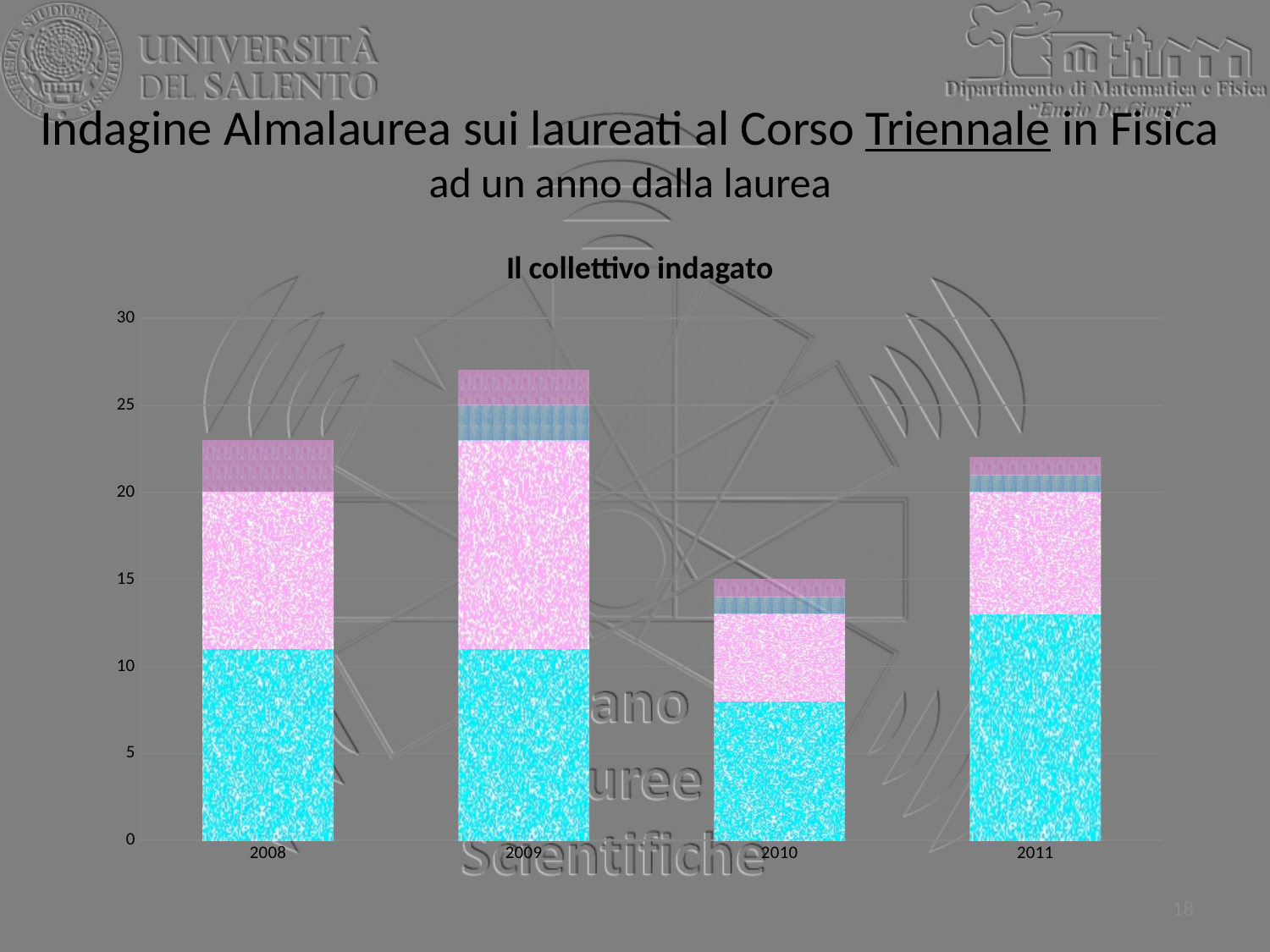
How many years (categories) are shown on the x axis of the chart? 4 Is the total stacked bar for 2010 greater or less than 20? less Which year has a taller stacked bar, 2009 or 2011? 2009 Is the total stacked bar for 2010 greater or less than 10? greater Is the bottom (cyan) segment of the 2010 bar greater or less than 10? less Which year has the tallest stacked bar? 2009 Which year has the shortest stacked bar? 2010 What is the title of the chart? Il collettivo indagato What kind of chart is shown on the slide? stacked bar chart Which year has a taller stacked bar, 2008 or 2010? 2008